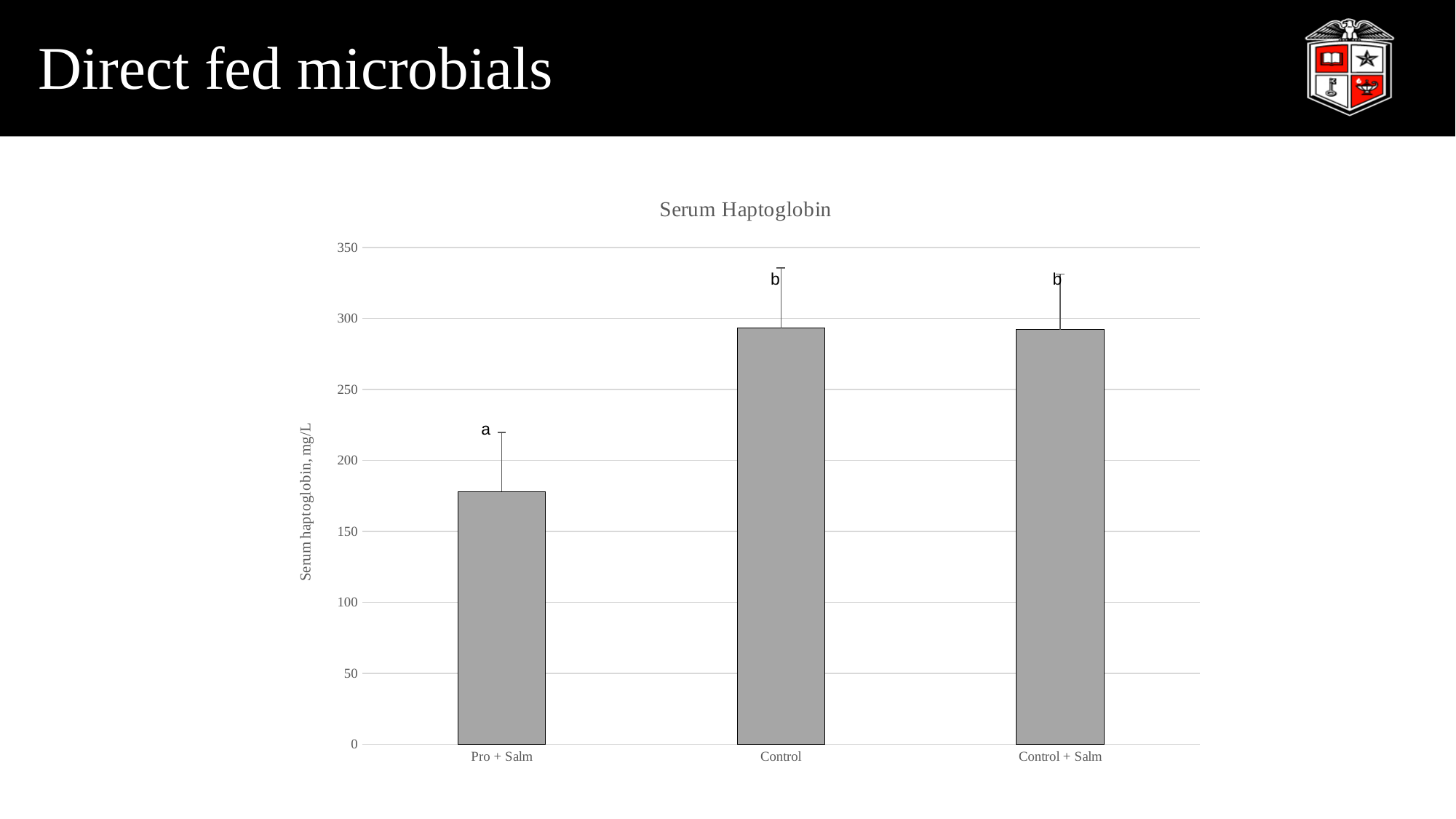
Is the value for Pro + Salm greater or less than 150? greater What kind of chart is shown on the slide? bar chart What is the label on the y axis of the chart? Serum haptoglobin, mg/L How many categories are plotted on the x axis? 3 Which category has the lowest serum haptoglobin value? Pro + Salm Is the value for Pro + Salm greater or less than 200? less Is the value for Control greater or less than 250? greater Which is larger, the value for Control + Salm or the value for Pro + Salm? Control + Salm Which is larger, the value for Pro + Salm or the value for Control? Control What is the title of the chart? Serum Haptoglobin